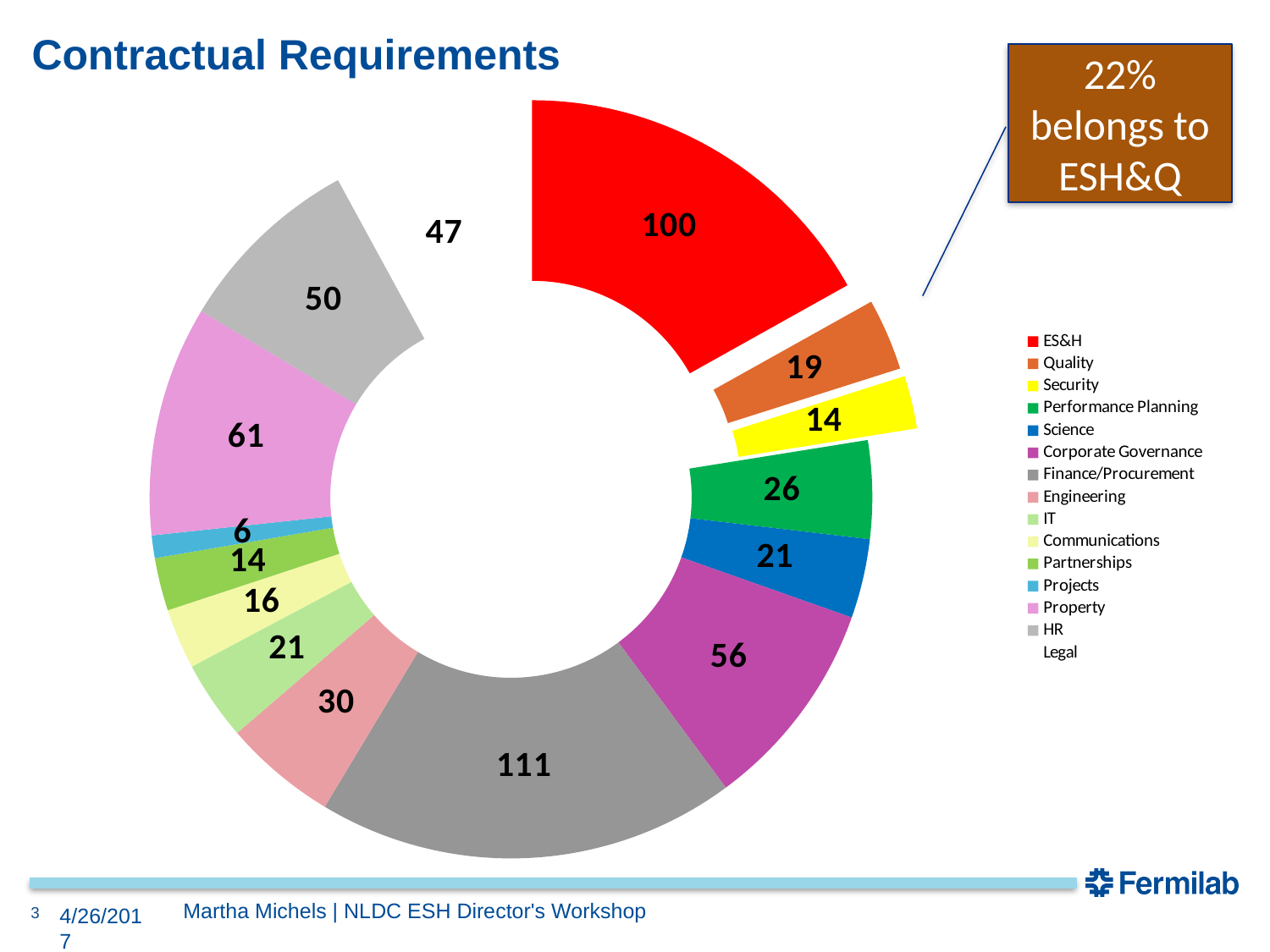
Which category has the largest value? Finance/Procurement What is the value for Engineering? 30 What kind of chart is shown on the slide? doughnut chart What is the value for Finance/Procurement? 111 How many categories does the legend list? 15 Which category has the smallest value? Projects What is the value for Projects? 6 According to the callout box on the slide, what percentage belongs to ESH&Q? 22% What is the value for Property? 61 What is the value for ES&H? 100 Which is larger, the value for Corporate Governance or the value for HR? Corporate Governance What is the difference between the values for Finance/Procurement and ES&H? 11